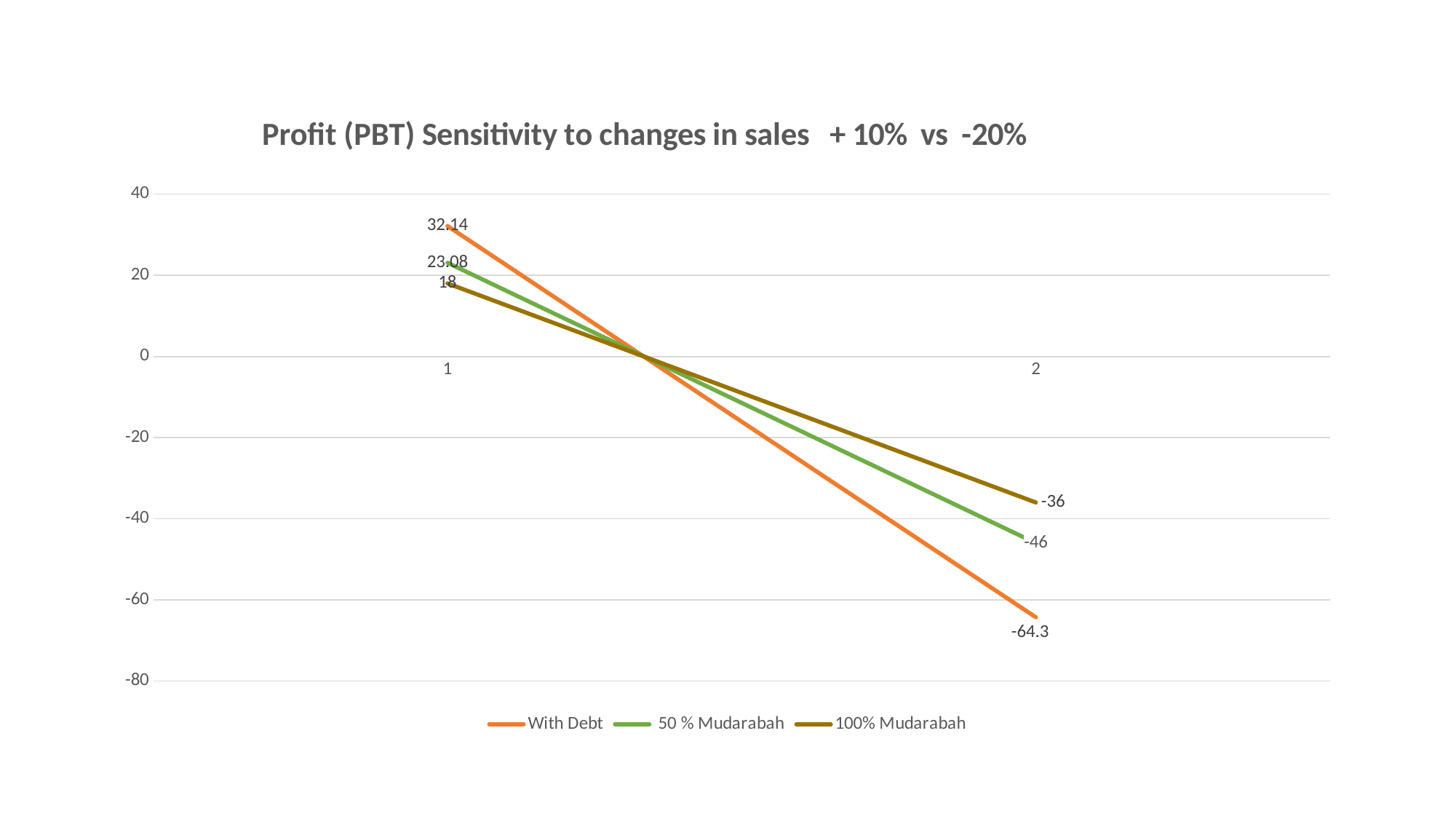
Which series has the lowest value at point 2? With Debt What is the difference between the With Debt value and the 100% Mudarabah value at point 1? 14.14 Which series has the highest value at point 1? With Debt Is the value for 50 % Mudarabah at point 1 greater or less than 20? greater What is the value of the 100% Mudarabah series at point 1? 18 What is the value of the With Debt series at point 1? 32.14 At point 2, which is larger: the 50 % Mudarabah value or the 100% Mudarabah value? 100% Mudarabah Do the values of the With Debt series rise or fall from point 1 to point 2? Fall What kind of chart is shown on the slide? Line chart How many series does the legend list? 3 What is the value of the 50 % Mudarabah series at point 2? -46 What is the value of the With Debt series at point 2? -64.3